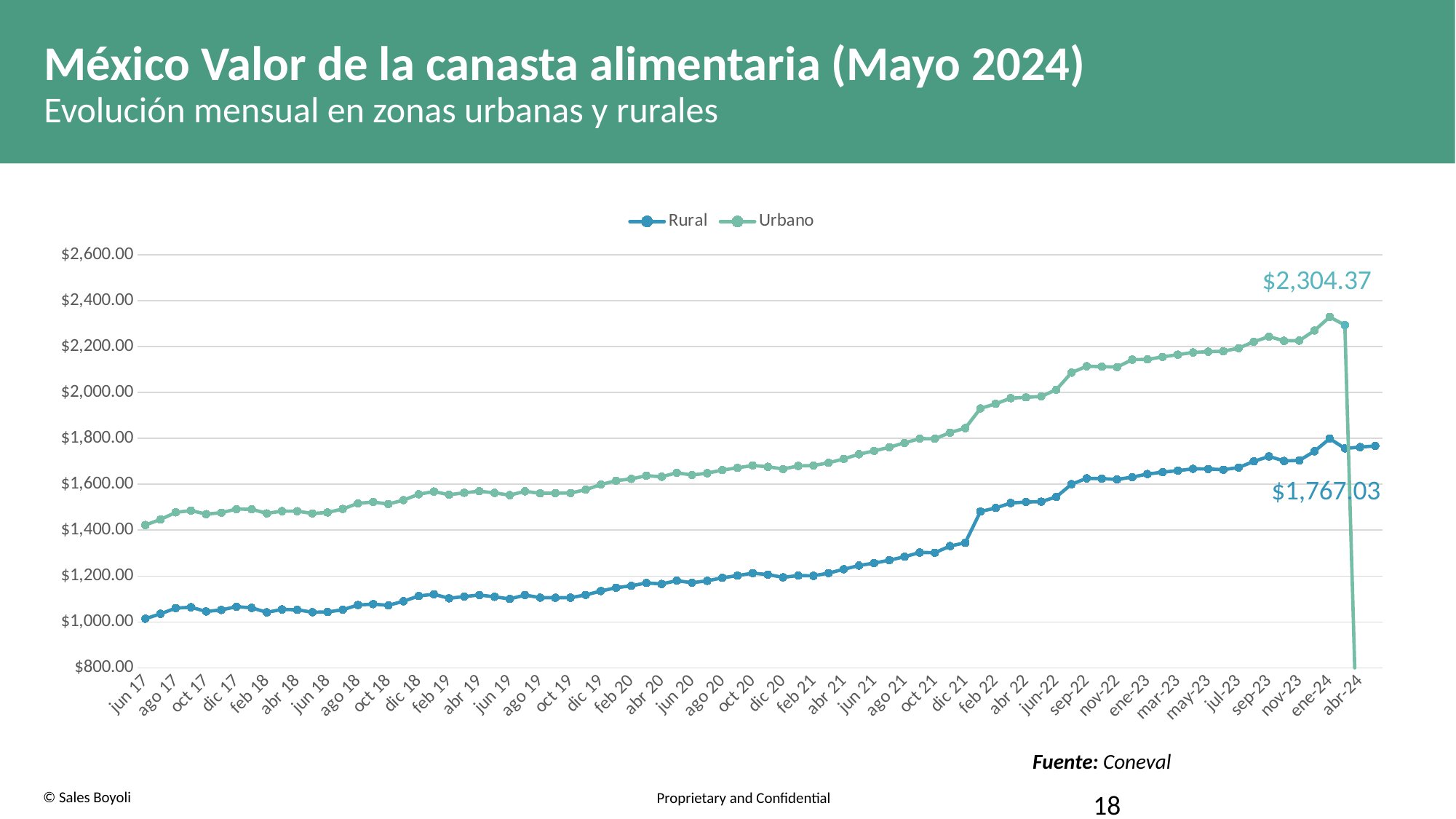
How many series does the legend list? 2 What value is printed as the data label for the Urbano series? $2,304.37 Is the Urbano value for jun 17 greater or less than $1,600.00? less What is the difference between the labeled Urbano value ($2,304.37) and the labeled Rural value ($1,767.03)? $537.34 Does the Rural series generally rise or fall from jun 17 to ene-24? rise Is the Rural value for jun 17 greater or less than $1,200.00? less What kind of chart is shown on the slide? line chart What source is cited for the chart data? Coneval What are the two series named in the legend? Rural and Urbano Which series has the higher labeled value, Rural or Urbano? Urbano Is the Urbano value for ene-24 greater or less than $2,200.00? greater What value is printed as the data label for the Rural series? $1,767.03